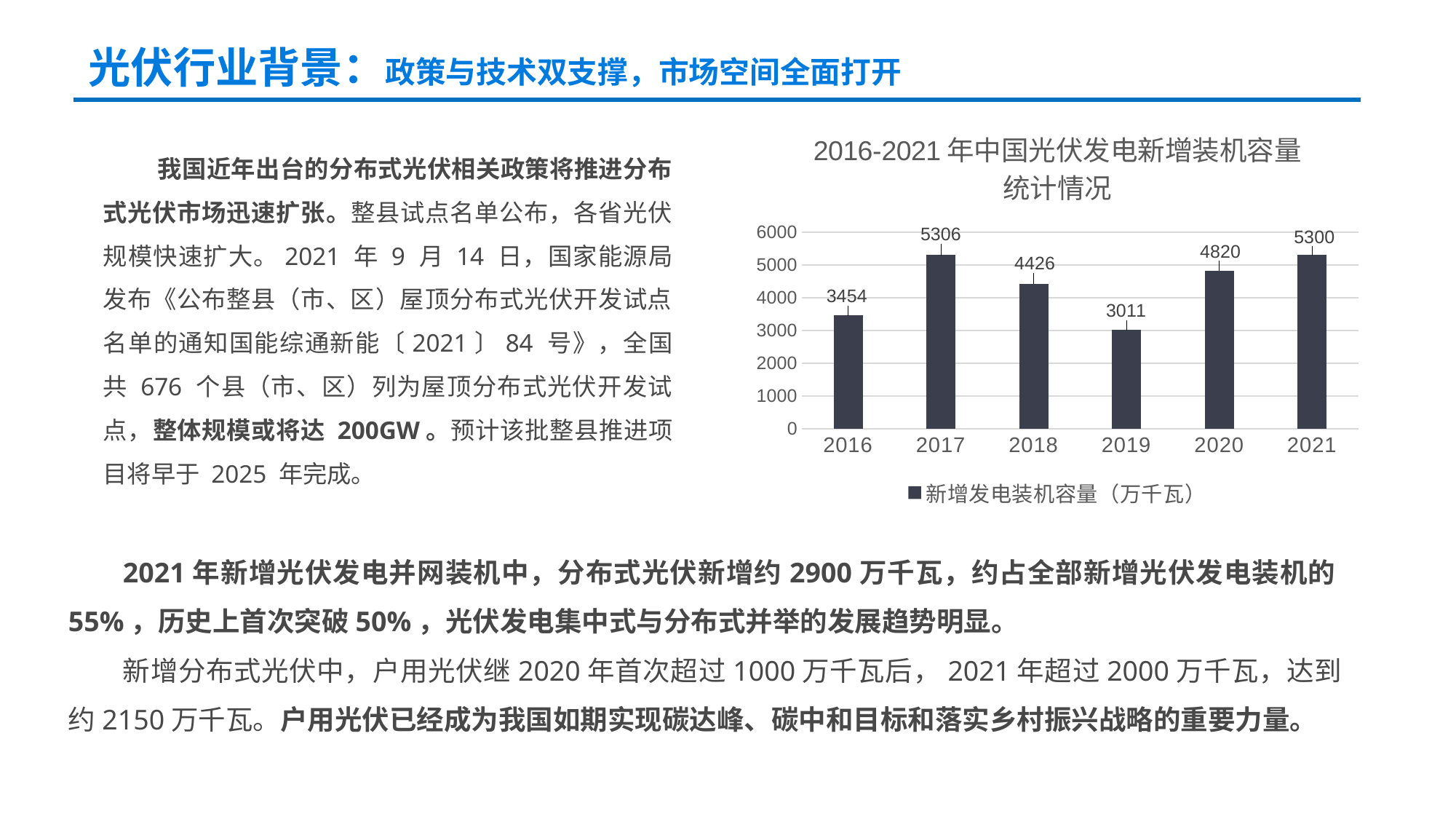
How many years are shown on the x axis of the chart? 6 What is the difference between the values for 2021 and 2019? 2289 What is the value for 2019 in the chart? 3011 Which year has the lowest value in the chart? 2019 What is the value for 2020 in the chart? 4820 What is the difference between the values for 2017 and 2016? 1852 What kind of chart is shown on the slide? bar chart What is the legend entry of the chart? 新增发电装机容量（万千瓦） Which is larger, the value for 2018 or the value for 2020? 2020 What is the value for 2016 in the chart? 3454 Which year has the highest value in the chart? 2017 Is the value for 2019 greater or less than 4000? less